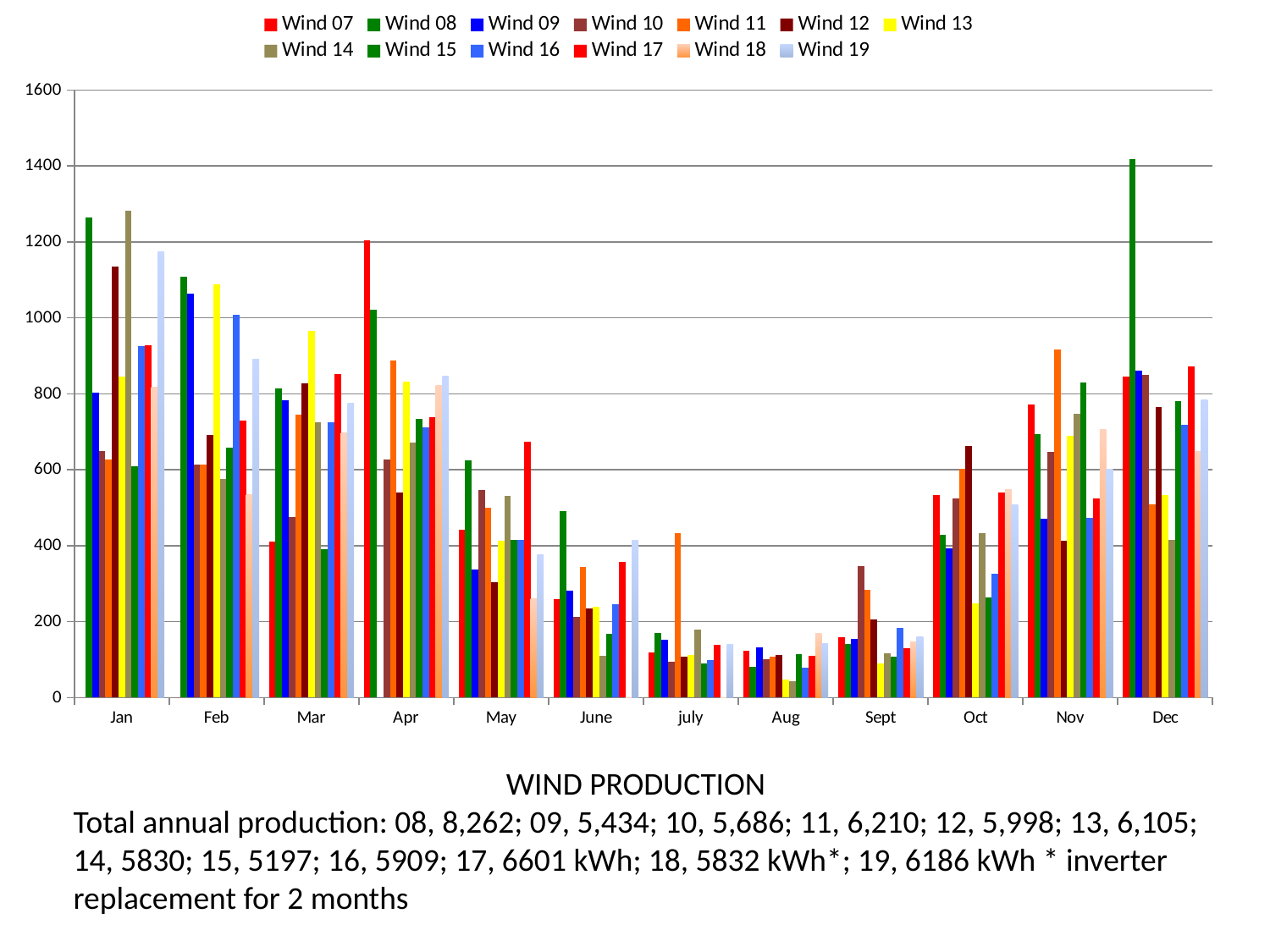
What is the title of the chart? WIND PRODUCTION What colour represents Wind 13 in the legend? yellow How many month categories are shown on the x axis? 12 Is the value for Wind 11 in Nov greater or less than 800? greater In which month does the tallest bar on the chart appear? Dec How many series does the legend list? 13 Is the value for Wind 08 in Dec greater or less than 1200? greater What kind of chart is shown on the slide? bar chart Which is larger for Wind 08: the Jan value or the Dec value? Dec Is the value for Wind 13 in Aug greater or less than 100? less In which month is the Wind 13 value lowest? Aug